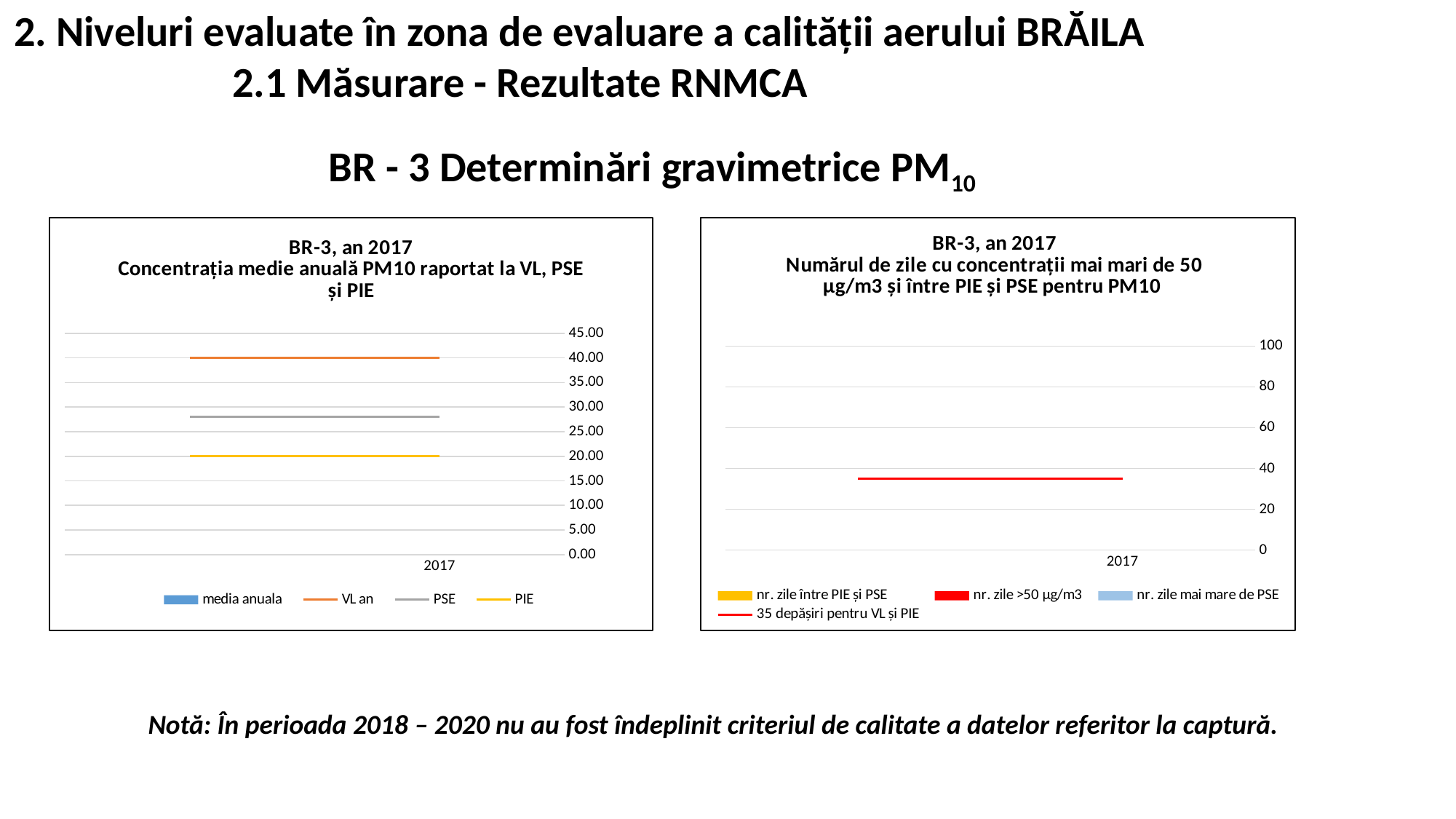
In the left chart (Concentrația medie anuală PM10), which of the plotted lines is the lowest? PIE In the left chart (Concentrația medie anuală PM10), is the PSE line greater or less than 30.00? less In the left chart (Concentrația medie anuală PM10), what is the difference between the VL an line and the PIE line? 20.00 In the left chart (Concentrația medie anuală PM10), which is higher, the VL an line or the PSE line? VL an In the right chart (Numărul de zile cu concentrații mai mari de 50 µg/m3), is the red line greater or less than 20? greater How many series does the legend of the right chart (Numărul de zile cu concentrații mai mari de 50 µg/m3) list? 4 In the left chart (Concentrația medie anuală PM10), what value does the PIE line sit at? 20.00 In the right chart (Numărul de zile cu concentrații mai mari de 50 µg/m3), is the red line greater or less than 40? less How many categories are shown on the x axis of the left chart (Concentrația medie anuală PM10)? 1 How many series does the legend of the left chart (Concentrația medie anuală PM10) list? 4 In the left chart (Concentrația medie anuală PM10), what value does the VL an line sit at? 40.00